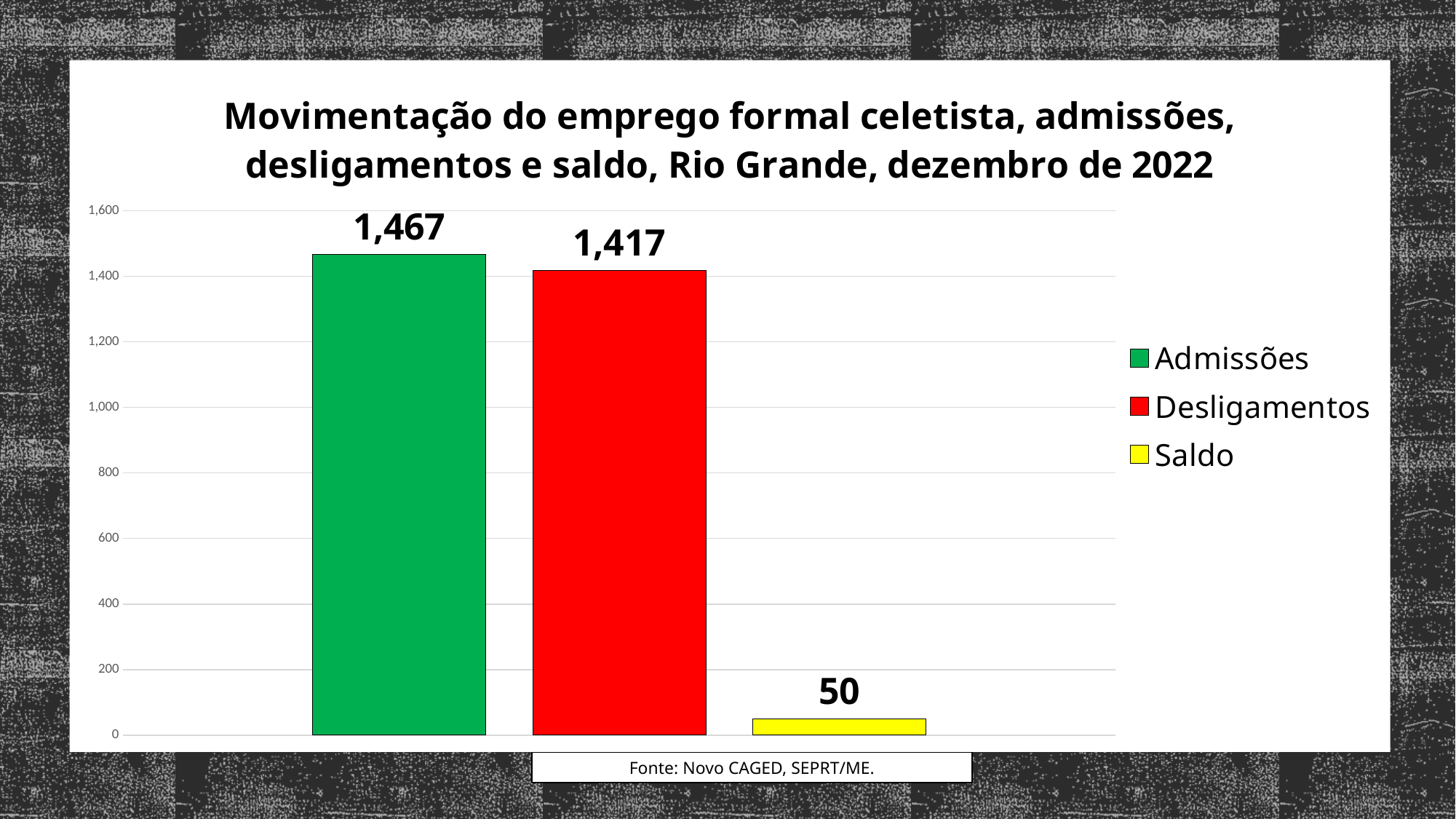
What colour is the bar for Saldo? Yellow What is the value for Desligamentos? 1,417 What is the value for Saldo? 50 How many bars are plotted in the chart? 3 Which series has the highest value? Admissões Which is larger, Admissões or Desligamentos? Admissões What is the difference between Admissões and Desligamentos? 50 How many series does the legend list? 3 Which series has the lowest value? Saldo What kind of chart is shown on the slide? Bar chart What is the value for Admissões? 1,467 Is the value for Desligamentos greater or less than 1,400? greater